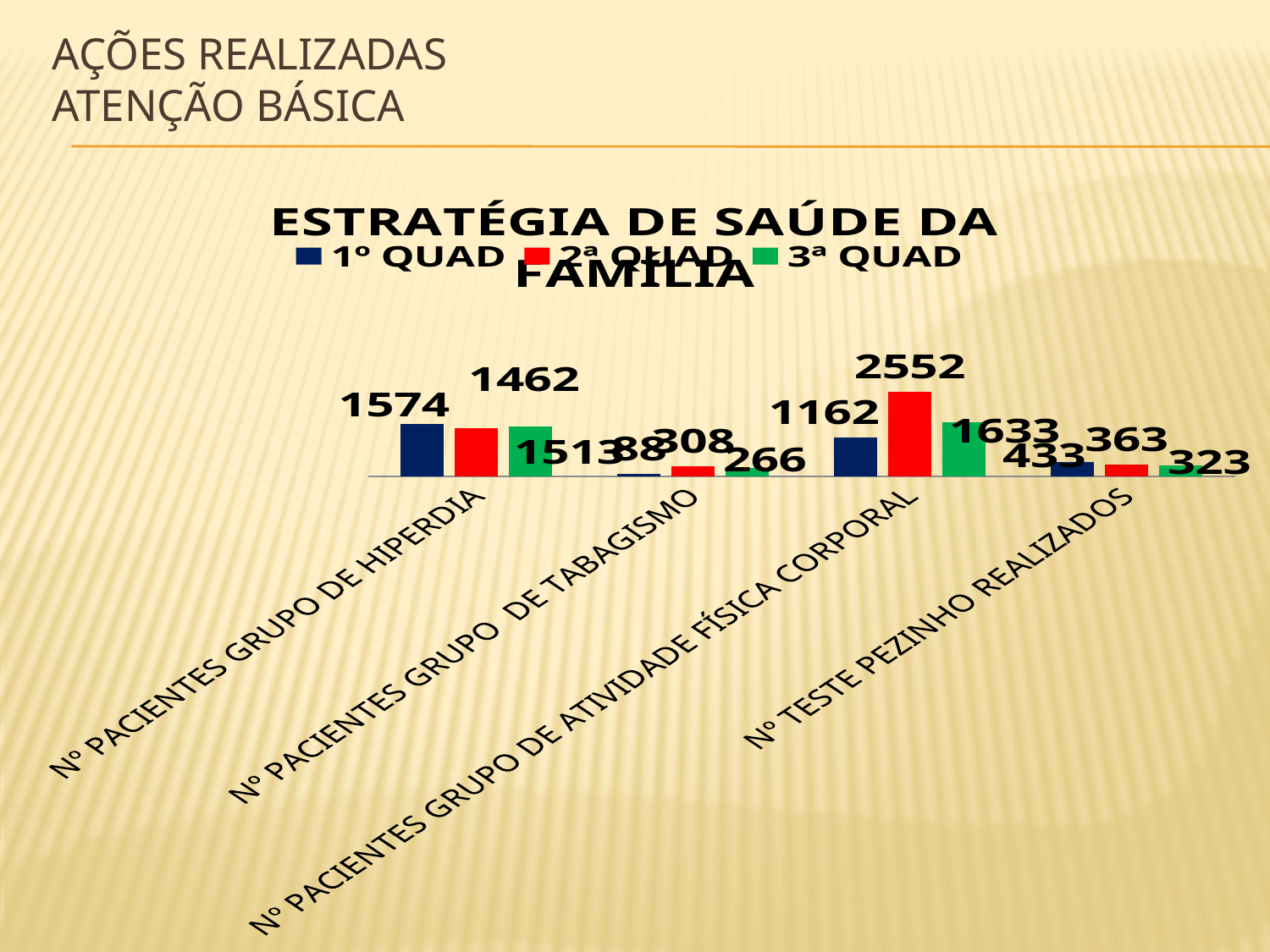
Which is larger: the 1º QUAD value for Nº PACIENTES GRUPO DE HIPERDIA or the 1º QUAD value for Nº PACIENTES GRUPO DE ATIVIDADE FÍSICA CORPORAL? Nº PACIENTES GRUPO DE HIPERDIA What is the difference between the 2ª QUAD and 1º QUAD values for Nº PACIENTES GRUPO DE ATIVIDADE FÍSICA CORPORAL? 1390 What kind of chart is shown on the slide? bar chart What is the 2ª QUAD value for Nº PACIENTES GRUPO DE ATIVIDADE FÍSICA CORPORAL? 2552 What is the 3ª QUAD value for Nº PACIENTES GRUPO DE ATIVIDADE FÍSICA CORPORAL? 1633 Which category has the highest 2ª QUAD value? Nº PACIENTES GRUPO DE ATIVIDADE FÍSICA CORPORAL How many categories are shown on the x axis? 4 What is the 1º QUAD value for Nº PACIENTES GRUPO DE HIPERDIA? 1574 Which series has the lowest value for Nº TESTE PEZINHO REALIZADOS? 3ª QUAD Do the values for Nº TESTE PEZINHO REALIZADOS rise or fall from 1º QUAD to 3ª QUAD? fall What is the 3ª QUAD value for Nº TESTE PEZINHO REALIZADOS? 323 How many series does the legend list? 3